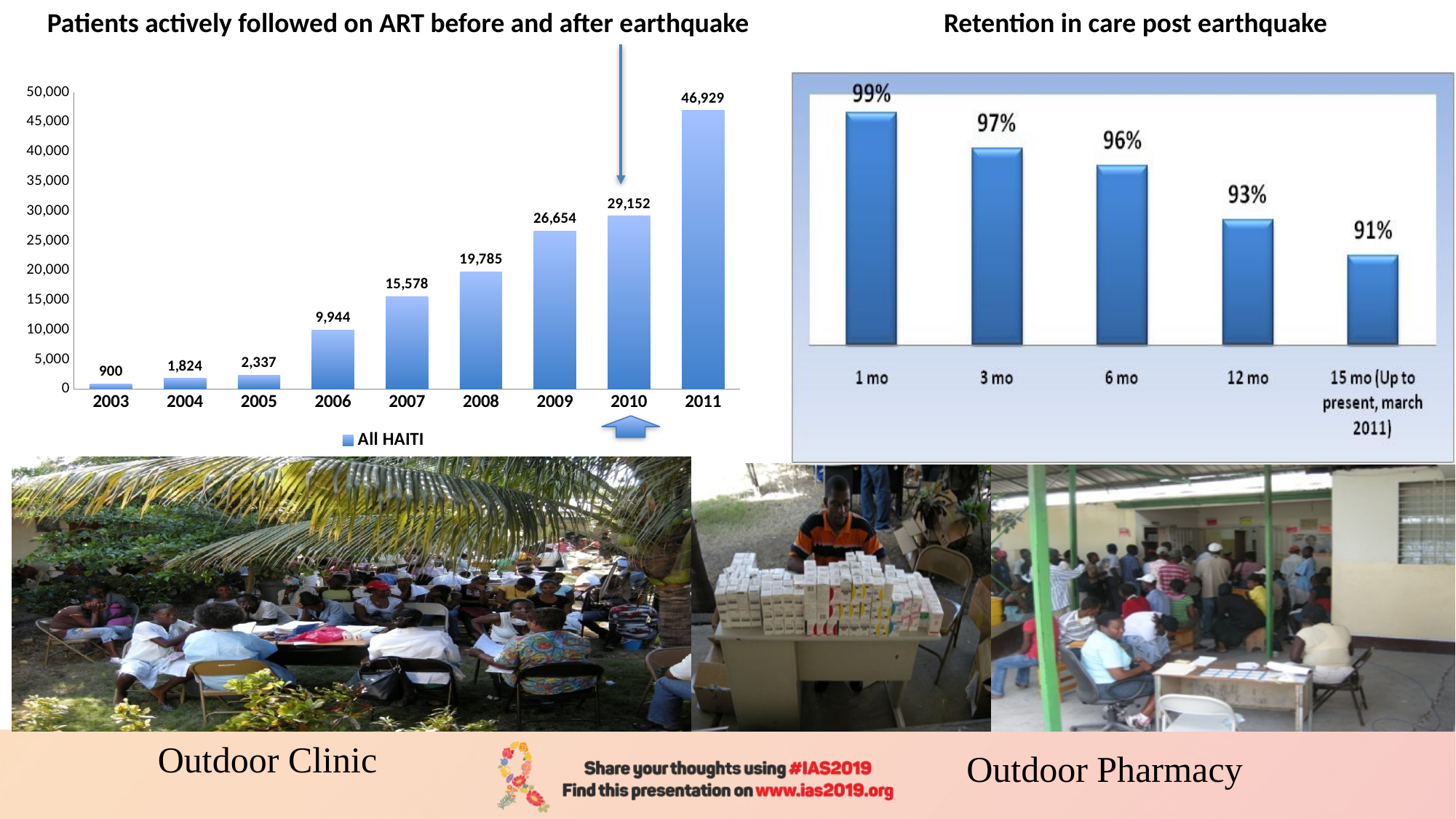
In the 'Patients actively followed on ART before and after earthquake' chart, what series name does the legend show? All HAITI In the 'Patients actively followed on ART before and after earthquake' chart, what is the value for 2010? 29,152 In the 'Retention in care post earthquake' chart, what is the difference between the 1 mo and 12 mo values? 6% In the 'Patients actively followed on ART before and after earthquake' chart, which year has the lowest value? 2003 In the 'Patients actively followed on ART before and after earthquake' chart, how many years are shown on the x axis? 9 In the 'Patients actively followed on ART before and after earthquake' chart, what is the difference between the 2011 and 2010 values? 17,777 In the 'Retention in care post earthquake' chart, what is the value for 6 mo? 96% In the 'Patients actively followed on ART before and after earthquake' chart, do the values rise or fall from 2003 to 2011? rise In the 'Retention in care post earthquake' chart, which category has the lowest value? 15 mo (Up to present, march 2011) What kind of chart is the 'Retention in care post earthquake' chart? bar chart In the 'Patients actively followed on ART before and after earthquake' chart, what is the value for 2007? 15,578 In the 'Patients actively followed on ART before and after earthquake' chart, which year has the highest value? 2011